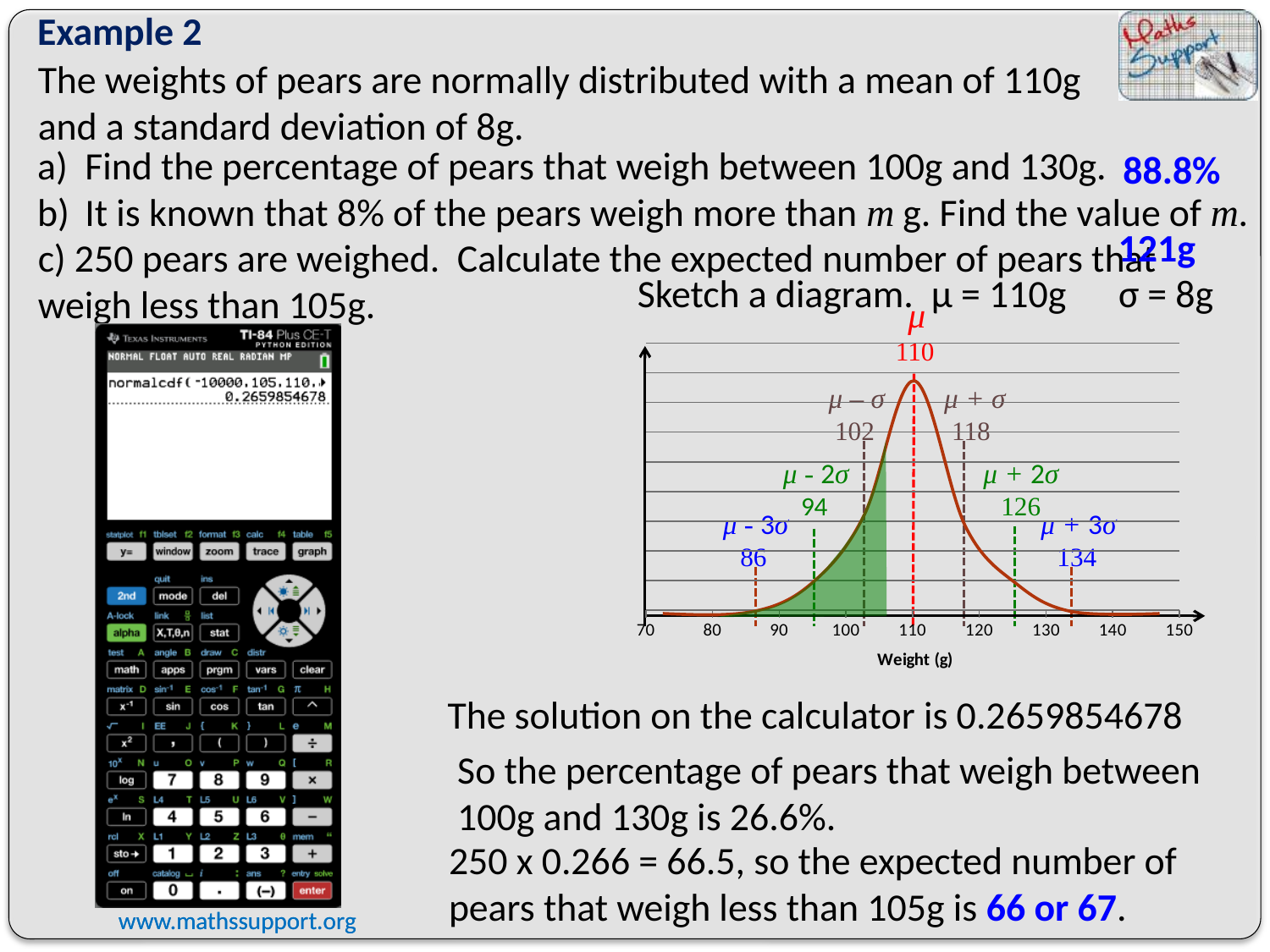
What value is marked at μ + σ on the normal distribution sketch? 118 What is the highest value shown on the x-axis of the normal distribution sketch? 150 What is the difference between the values marked at μ + 3σ and μ − 3σ on the sketch? 48 What value is marked at μ on the normal distribution sketch? 110 What value is marked at μ − 3σ on the normal distribution sketch? 86 What is the lowest value shown on the x-axis of the normal distribution sketch? 70 What value is marked at μ − 2σ on the normal distribution sketch? 94 What colour is the shaded region under the curve on the normal distribution sketch? Green What value is marked at μ − σ on the normal distribution sketch? 102 What value is marked at μ + 3σ on the normal distribution sketch? 134 What value is marked at μ + 2σ on the normal distribution sketch? 126 What is the x-axis label of the normal distribution sketch? Weight (g)